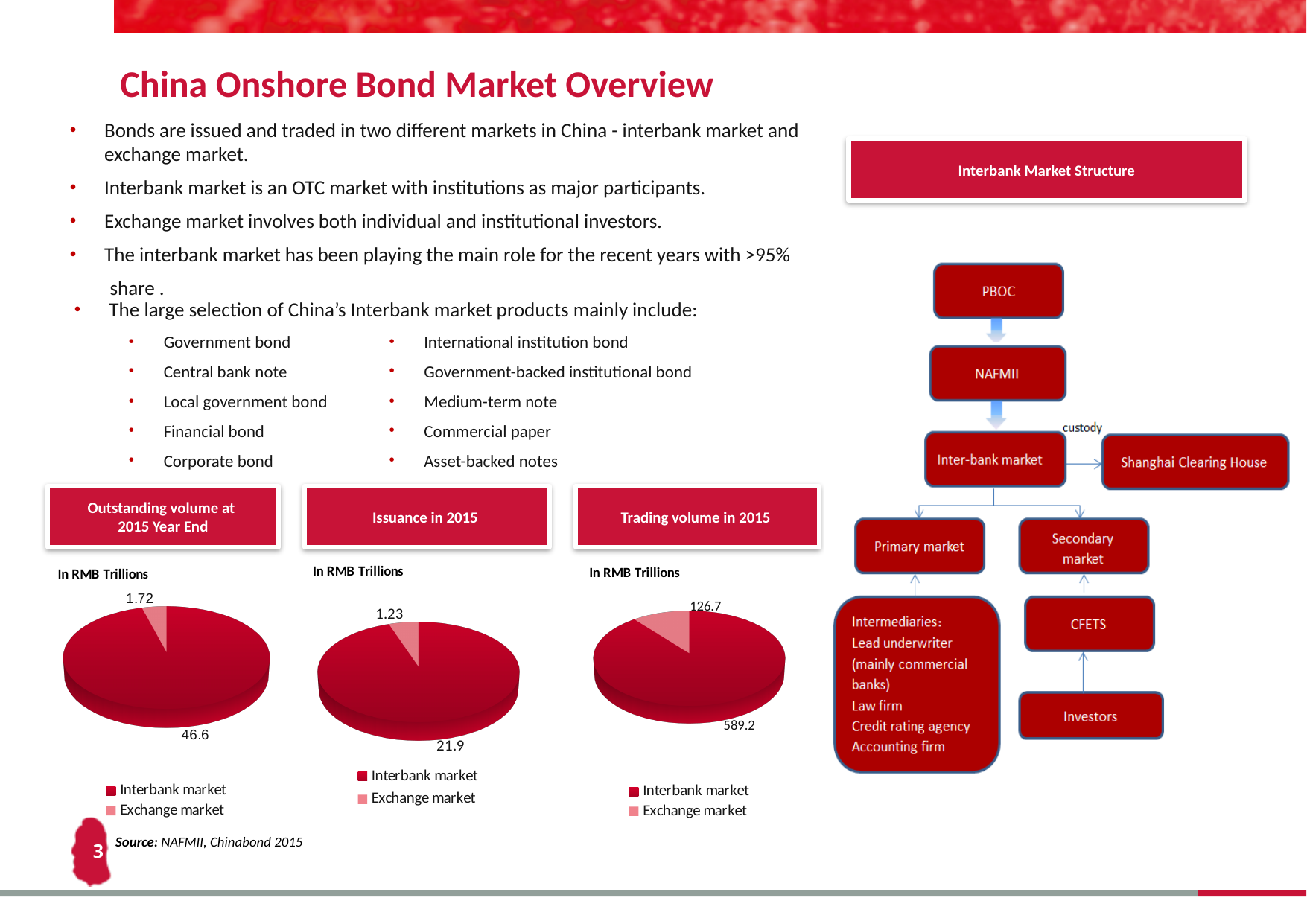
What type of chart is used for 'Issuance in 2015'? Pie chart In the 'Outstanding volume at 2015 Year End' chart, what is the total of the two slices? 48.32 In the 'Outstanding volume at 2015 Year End' chart, what is the value for the Exchange market? 1.72 In the 'Issuance in 2015' chart, which market has the smallest slice? Exchange market In the 'Trading volume in 2015' chart, what is the difference between the Interbank market and Exchange market values? 462.5 In the 'Trading volume in 2015' chart, what is the value for the Exchange market? 126.7 In the 'Outstanding volume at 2015 Year End' chart, what is the value for the Interbank market? 46.6 In the 'Issuance in 2015' chart, what is the value for the Exchange market? 1.23 In the 'Trading volume in 2015' chart, which market has the largest slice? Interbank market What unit is stated above the 'Issuance in 2015' chart? In RMB Trillions How many series does the legend of the 'Trading volume in 2015' chart list? 2 In the 'Issuance in 2015' chart, what is the value for the Interbank market? 21.9